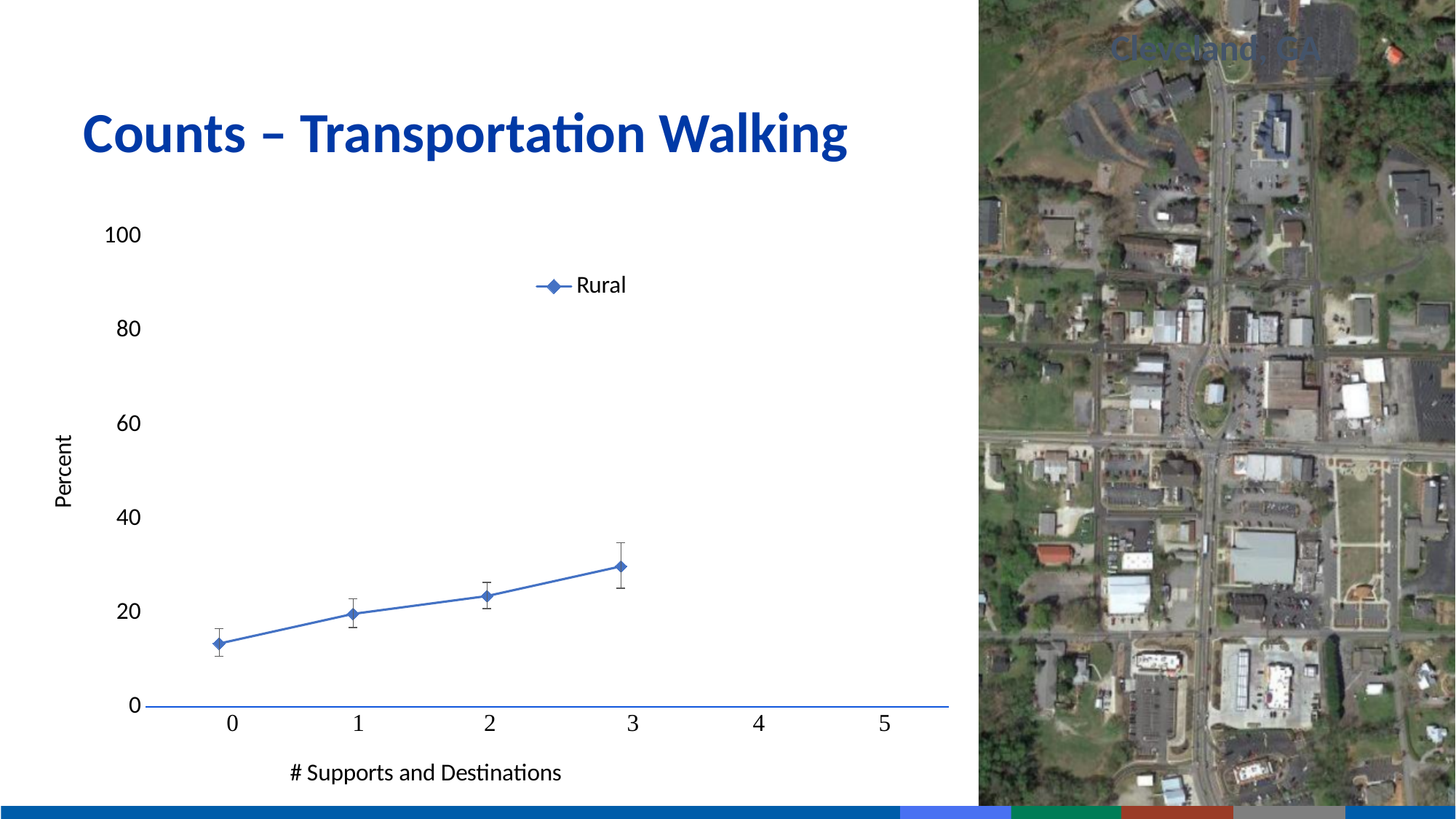
How many series does the legend list? 1 Is the Rural value at 0 supports and destinations greater or less than 20? less Do the Rural values rise or fall as the number of supports and destinations increases from 0 to 3? rise At which number of supports and destinations is the Rural value lowest? 0 Is the Rural value at 3 supports and destinations greater or less than 40? less Which is larger, the Rural value at 3 supports and destinations or at 1? 3 What is the label of the x axis? # Supports and Destinations Is the Rural value at 2 supports and destinations greater or less than 20? greater What kind of chart is shown on the slide? line chart How many data points are plotted for the Rural series? 4 What is the name of the series shown in the legend? Rural At which number of supports and destinations is the Rural value highest? 3